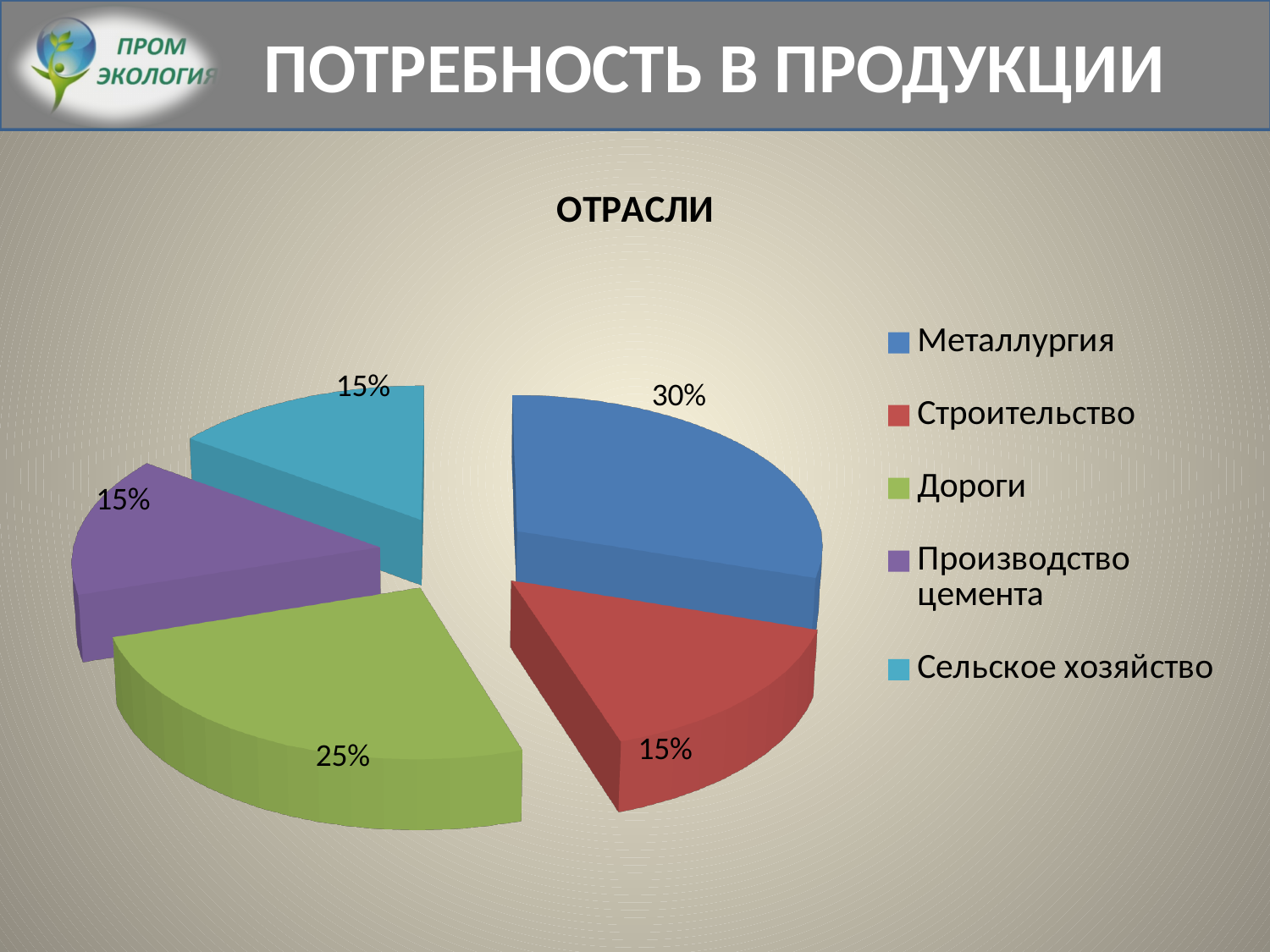
Which is larger, the share of Дороги or the share of Производство цемента? Дороги How many slices have a share of 15%? 3 What share of the pie does Металлургия have? 30% Which category has the largest slice of the pie? Металлургия What share of the pie does Сельское хозяйство have? 15% What is the title of the chart? ОТРАСЛИ What share of the pie does Строительство have? 15% How many categories does the legend list? 5 Which colour represents Дороги in the chart? green What is the difference between the shares of Металлургия and Дороги? 5% What kind of chart is shown on the slide? pie chart What share of the pie does Дороги have? 25%